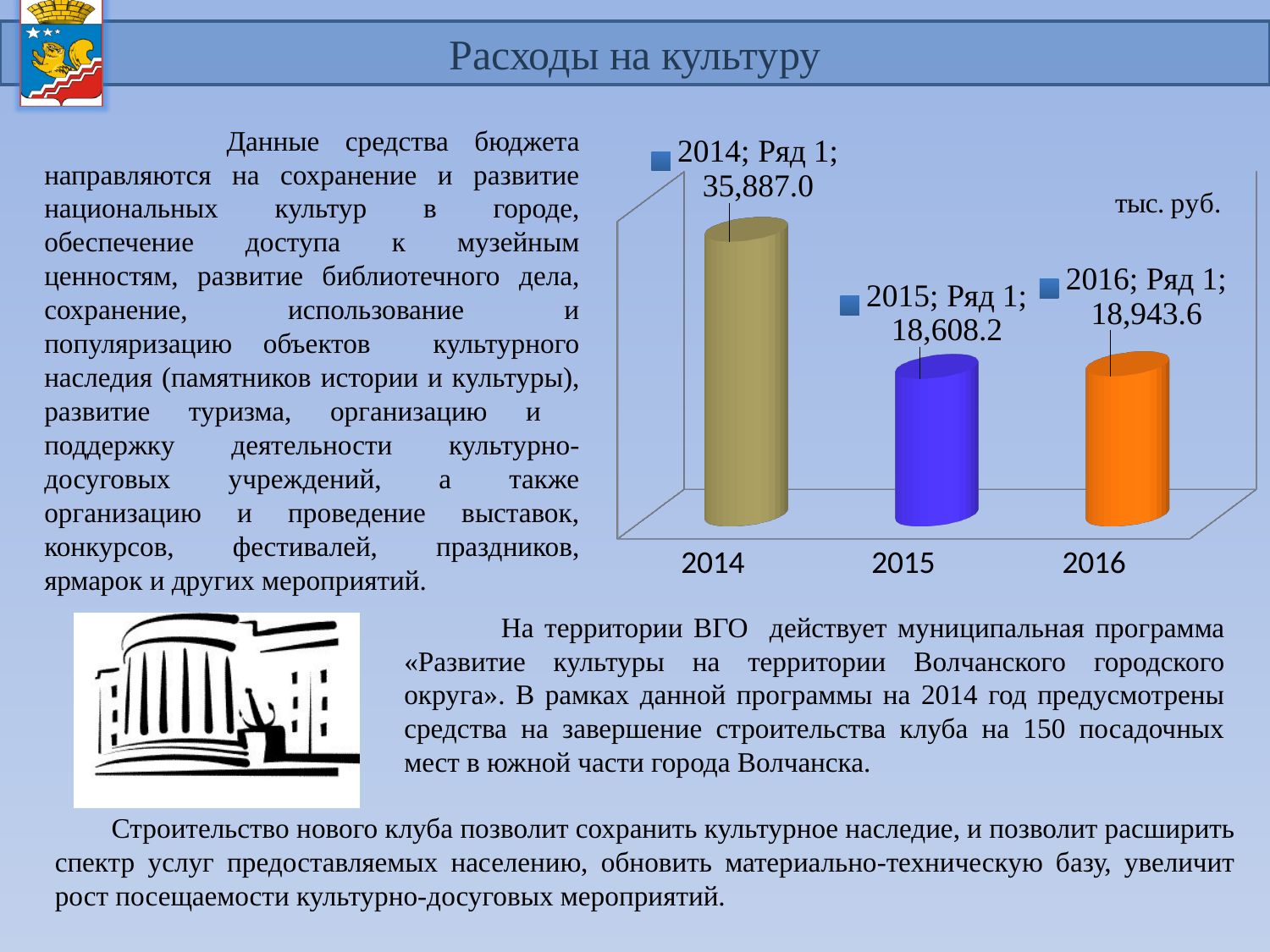
What is the difference between the values for 2014 and 2015? 17,278.8 What unit is indicated on the chart? тыс. руб. What is the difference between the values for 2016 and 2015? 335.4 How many years are shown on the chart? 3 What is the value for 2014? 35,887.0 Which year has the lowest value? 2015 What kind of chart is shown on the slide? bar chart Does the value rise or fall from 2014 to 2015? fall Which is larger, the value for 2015 or the value for 2016? 2016 Which year has the highest value? 2014 What is the value for 2015? 18,608.2 What is the value for 2016? 18,943.6